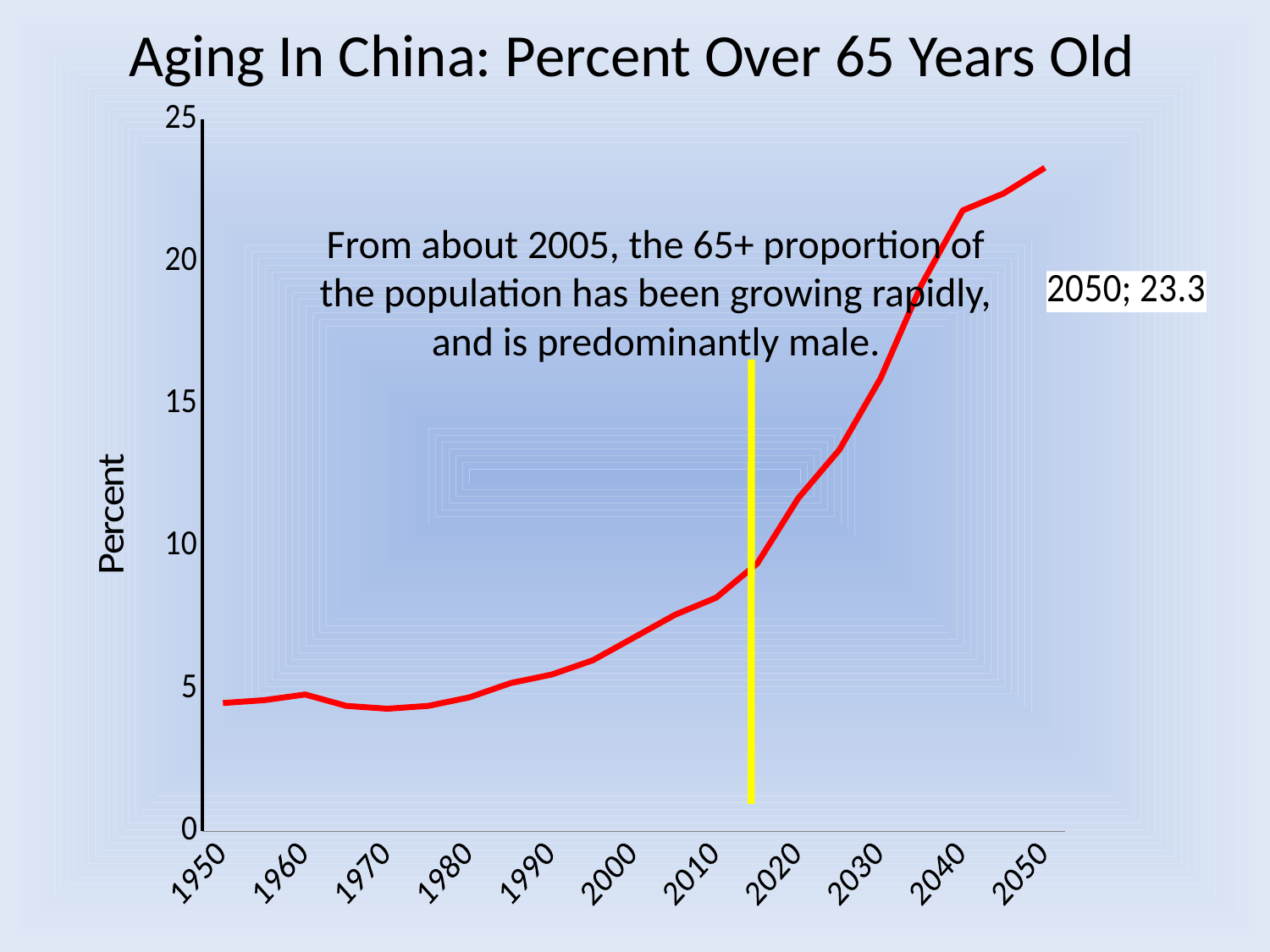
Is the value for 2040 greater or less than 20? greater Is the value for 1990 greater or less than 10? less What is the value shown by the data label for 2050? 23.3 What is the title of the chart? Aging In China: Percent Over 65 Years Old Do the values generally rise or fall from 1950 to 2050? rise What is the label on the vertical axis? Percent How many year labels are shown on the x axis? 11 What kind of chart is shown on the slide? line chart Is the value for 2030 greater or less than 10? greater Which year has the highest percent over 65 years old? 2050 Which year has the larger value, 2010 or 2030? 2030